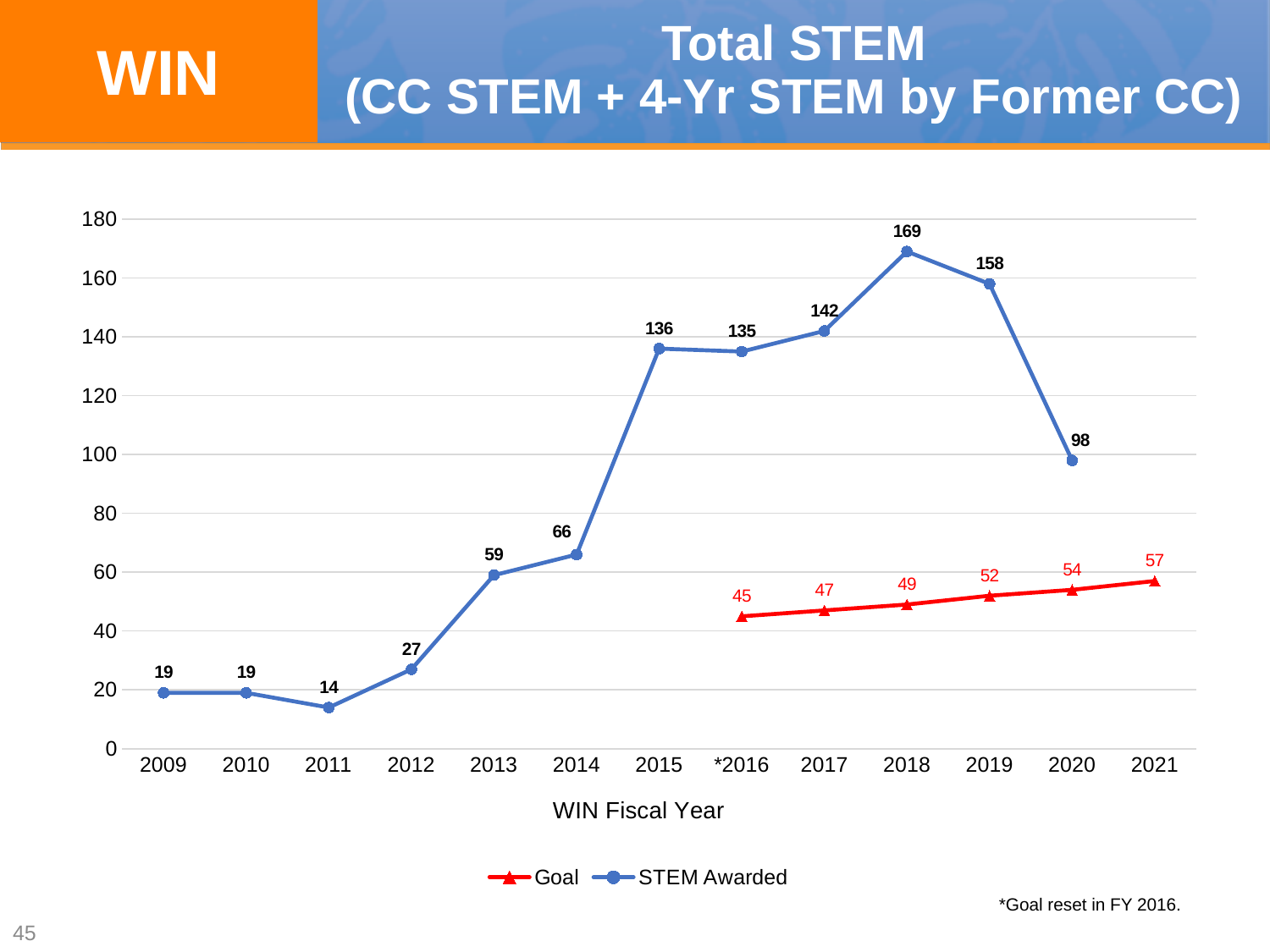
Does the Goal series rise or fall from 2016 to 2021? Rise What is the difference between STEM Awarded and the Goal in 2020? 44 What was the STEM Awarded value in 2018? 169 In which year was STEM Awarded highest? 2018 What is the difference between STEM Awarded in 2018 and 2019? 11 Which was larger in 2017, STEM Awarded or the Goal? STEM Awarded What is the label of the x axis? WIN Fiscal Year What was the Goal value for 2021? 57 In which year was STEM Awarded lowest? 2011 What was the STEM Awarded value in 2020? 98 How many series does the legend list? 2 What kind of chart is shown on the slide? Line chart